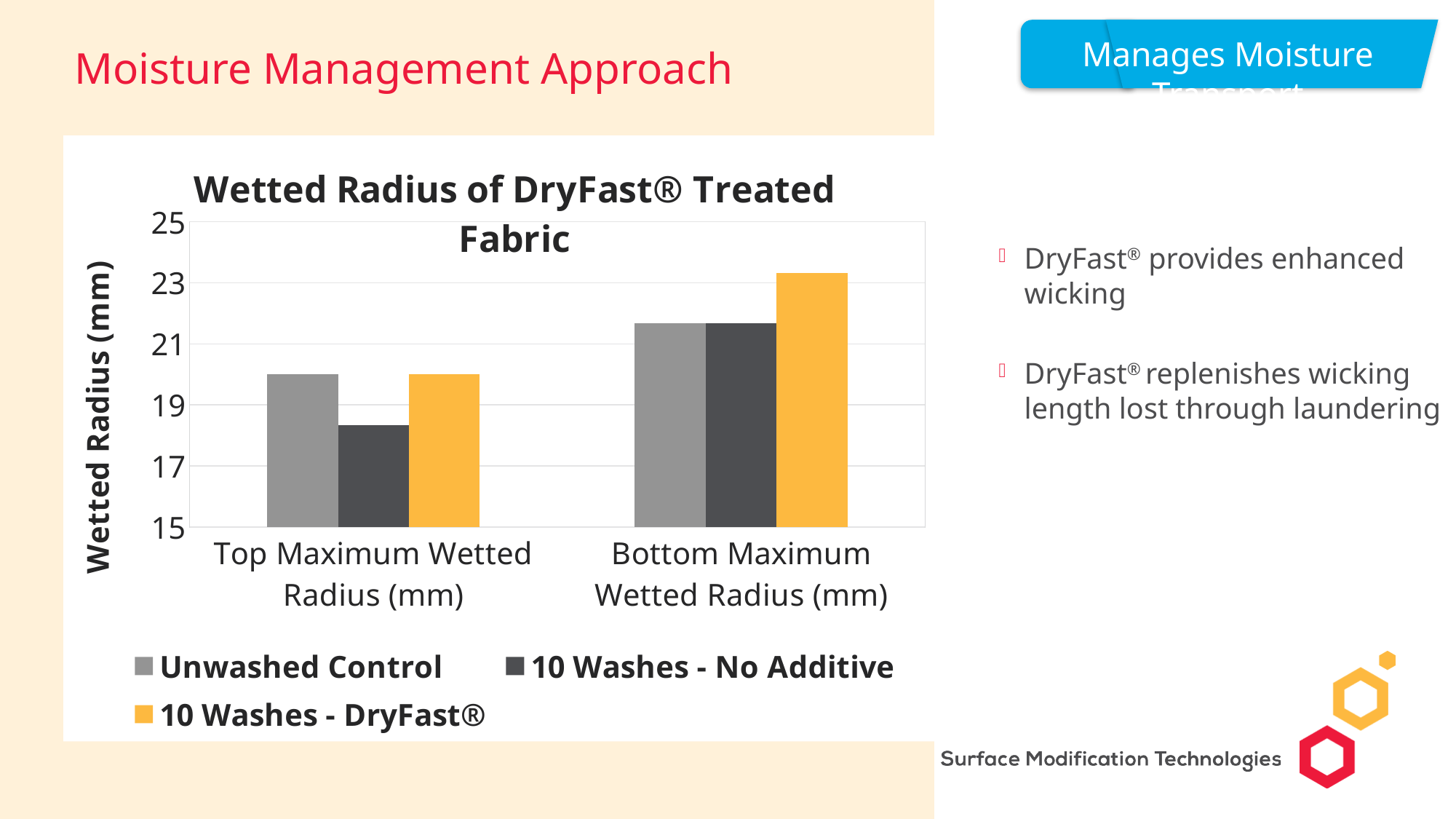
Is the value for 10 Washes - No Additive in the Top Maximum Wetted Radius (mm) category greater or less than 19? less What kind of chart is shown on the slide? bar chart How many series does the chart legend list? 3 What is the label of the vertical axis of the chart? Wetted Radius (mm) How many categories are shown on the x axis of the chart? 2 In the Top Maximum Wetted Radius (mm) category, which is larger: Unwashed Control or 10 Washes - No Additive? Unwashed Control In the Bottom Maximum Wetted Radius (mm) category, which is larger: 10 Washes - DryFast® or 10 Washes - No Additive? 10 Washes - DryFast® Which series has the highest bar in the Bottom Maximum Wetted Radius (mm) category? 10 Washes - DryFast® Is the value for 10 Washes - DryFast® in the Top Maximum Wetted Radius (mm) category greater or less than 21? less What is the title of the chart? Wetted Radius of DryFast® Treated Fabric Is the value for Unwashed Control in the Bottom Maximum Wetted Radius (mm) category greater or less than 21? greater Which series has the lowest bar in the Top Maximum Wetted Radius (mm) category? 10 Washes - No Additive